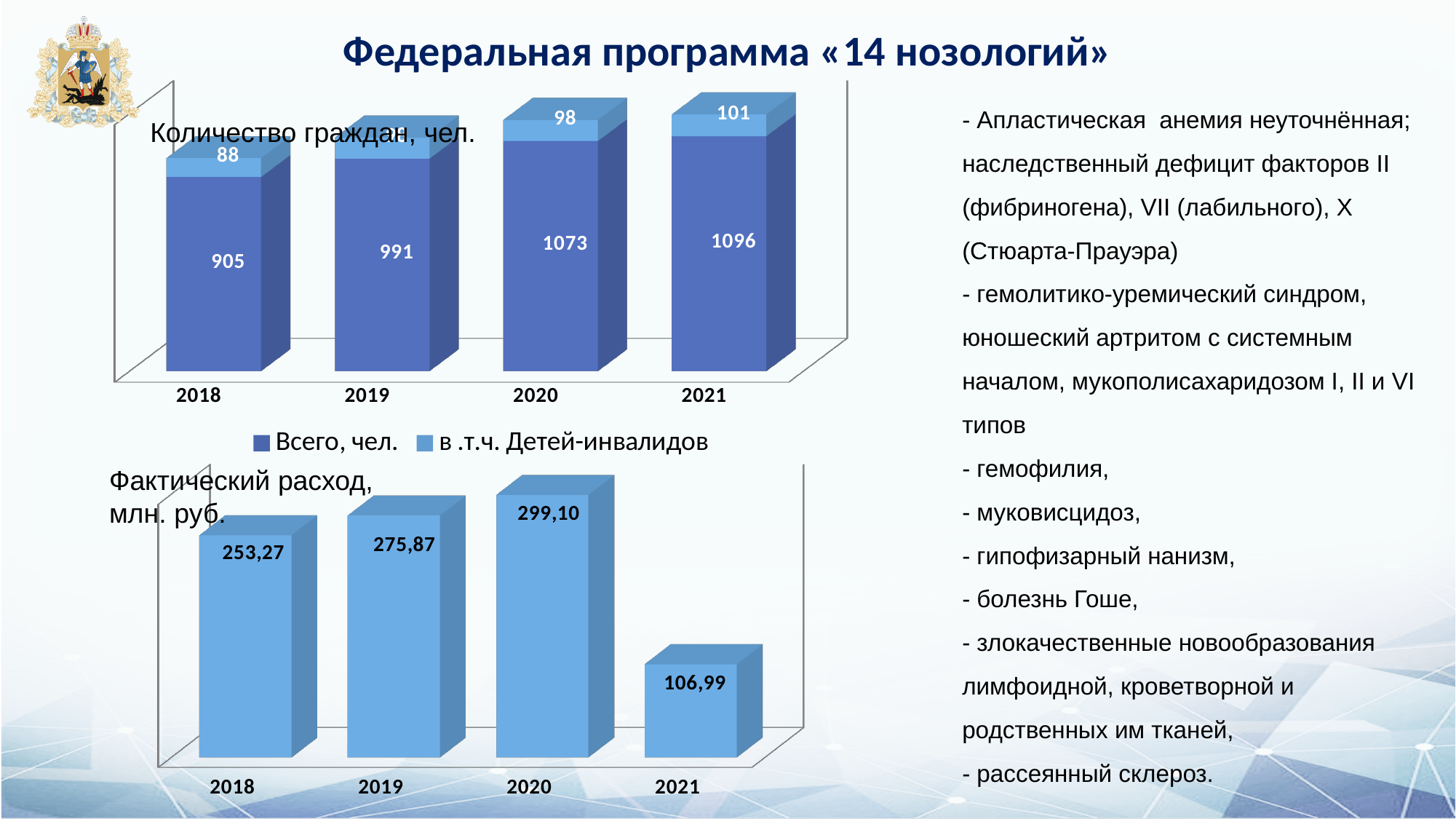
In the chart 'Фактический расход, млн. руб.', what is the value for 2020? 299,10 In the chart 'Фактический расход, млн. руб.', which year has the lowest value? 2021 In the chart 'Фактический расход, млн. руб.', what is the difference between the values for 2019 and 2018? 22,60 In the chart 'Количество граждан, чел.', how many series does the legend list? 2 In the chart 'Количество граждан, чел.', which year has the highest value for 'Всего, чел.'? 2021 In the chart 'Количество граждан, чел.', what is the difference between the 'Всего, чел.' values for 2021 and 2018? 191 In the chart 'Количество граждан, чел.', what is the total of the stacked bar for 2018? 993 In the chart 'Количество граждан, чел.', what is the value of 'Всего, чел.' for 2020? 1073 In the chart 'Количество граждан, чел.', what is the value of 'в .т.ч. Детей-инвалидов' for 2021? 101 What kind of chart is the chart 'Фактический расход, млн. руб.'? bar chart In the chart 'Фактический расход, млн. руб.', how many years are shown on the x axis? 4 In the chart 'Количество граждан, чел.', do the 'Всего, чел.' values rise or fall from 2018 to 2021? rise